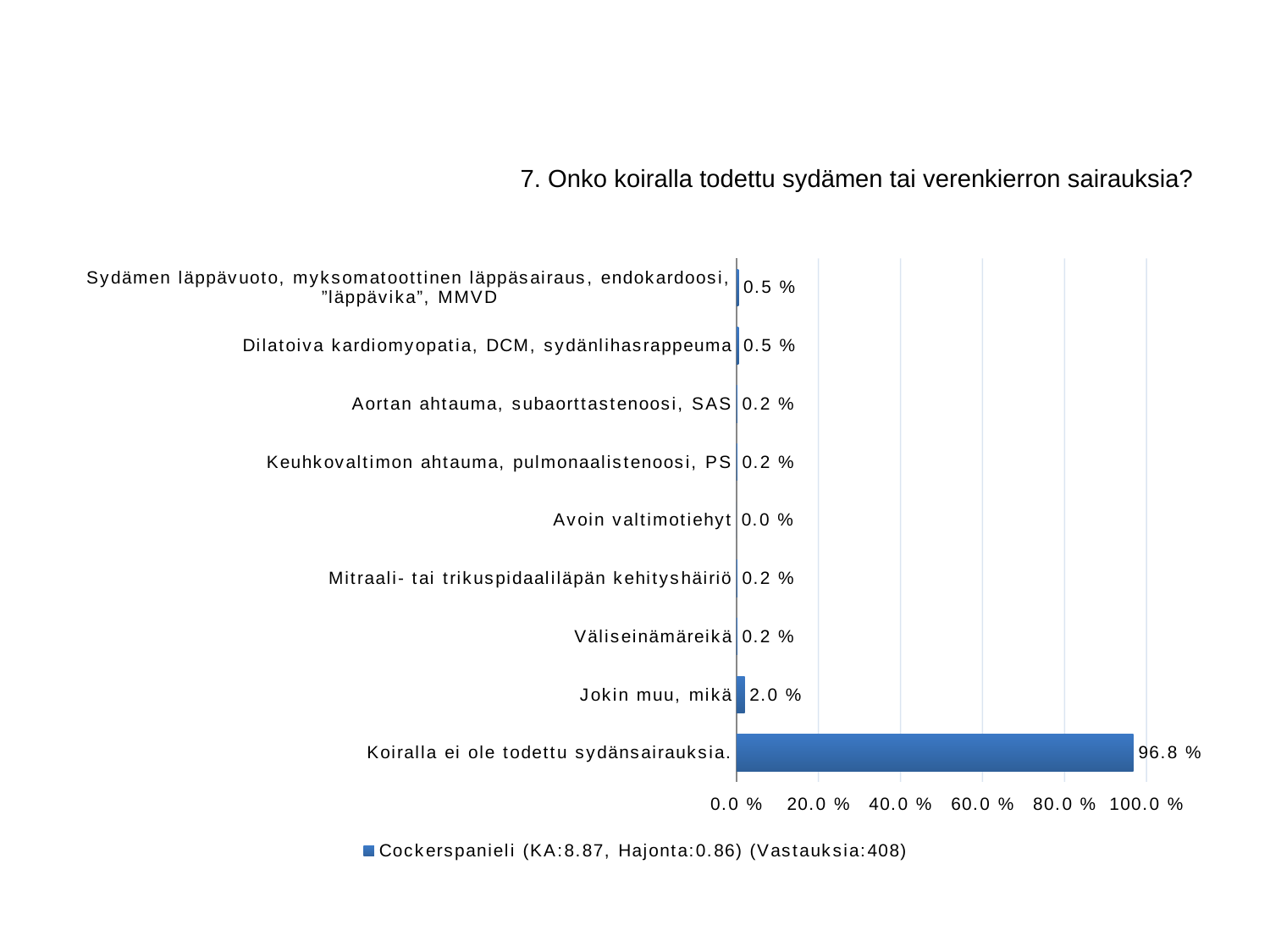
How many series does the legend list? 1 Which category has the highest value? Koiralla ei ole todettu sydänsairauksia. What is the value for "Dilatoiva kardiomyopatia, DCM, sydänlihasrappeuma"? 0.5 % How many categories are shown in the chart? 9 What kind of chart is shown on the slide? bar chart What is the value for "Jokin muu, mikä"? 2.0 % Is the value for "Koiralla ei ole todettu sydänsairauksia." greater or less than 80.0 %? greater What is the value for "Koiralla ei ole todettu sydänsairauksia."? 96.8 % What is the difference between the values for "Koiralla ei ole todettu sydänsairauksia." and "Jokin muu, mikä"? 94.8 % Which is larger, the value for "Jokin muu, mikä" or the value for "Väliseinämäreikä"? Jokin muu, mikä What is the value for "Avoin valtimotiehyt"? 0.0 % Which category has the lowest value? Avoin valtimotiehyt